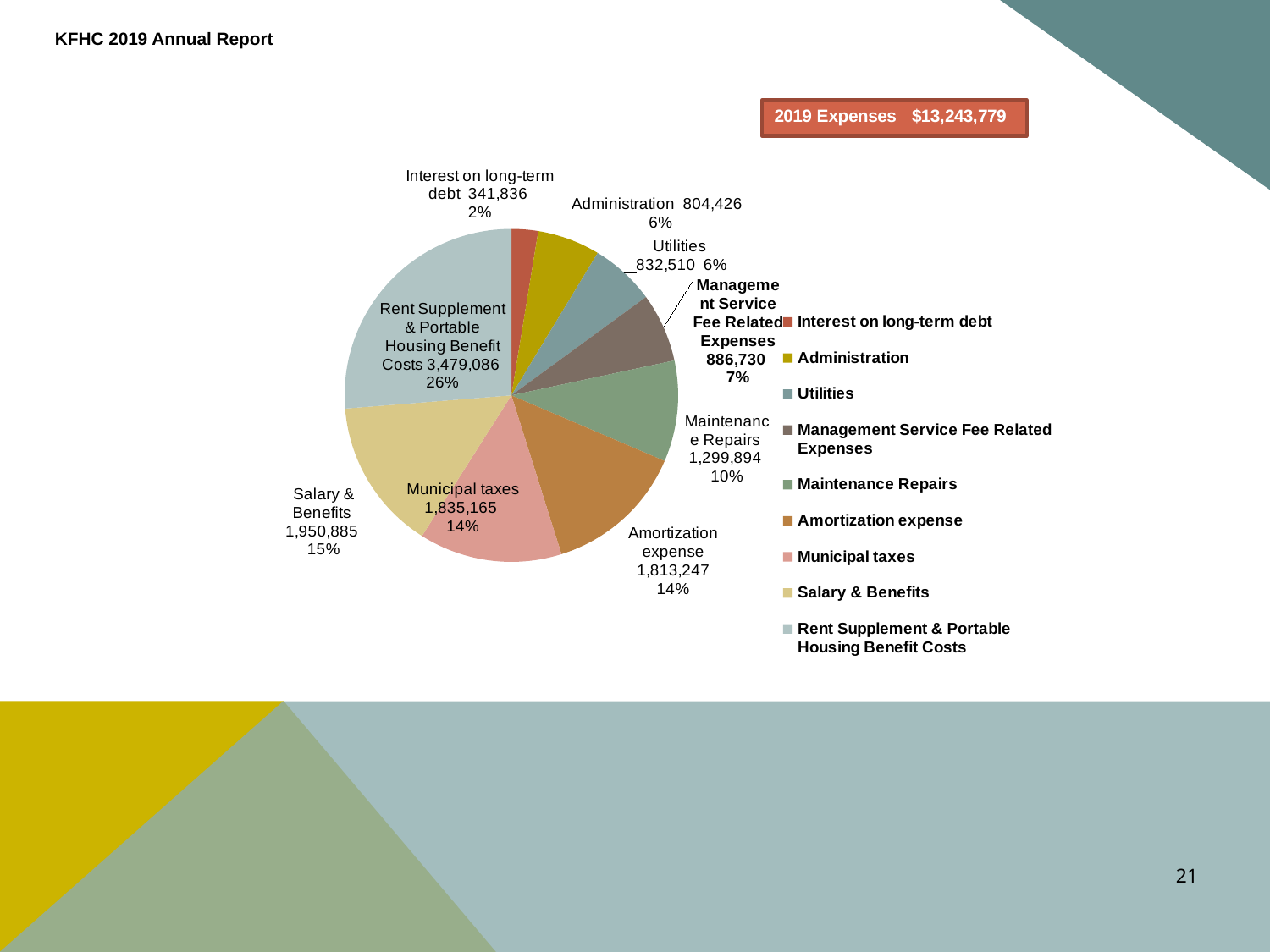
Which is larger, the value for Administration or the value for Utilities? Utilities What is the value for Maintenance Repairs? 1,299,894 What share of the pie does Salary & Benefits represent? 15% What total expense amount is shown in the box above the chart? $13,243,779 Which category has the largest slice of the pie? Rent Supplement & Portable Housing Benefit Costs What kind of chart is shown on the slide? pie chart Which category has the smallest slice of the pie? Interest on long-term debt What share of the pie does Management Service Fee Related Expenses represent? 7% What is the difference between the values for Salary & Benefits and Municipal taxes? 115,720 What is the value for Municipal taxes? 1,835,165 What is the value for Interest on long-term debt? 341,836 How many categories does the pie chart have? 9